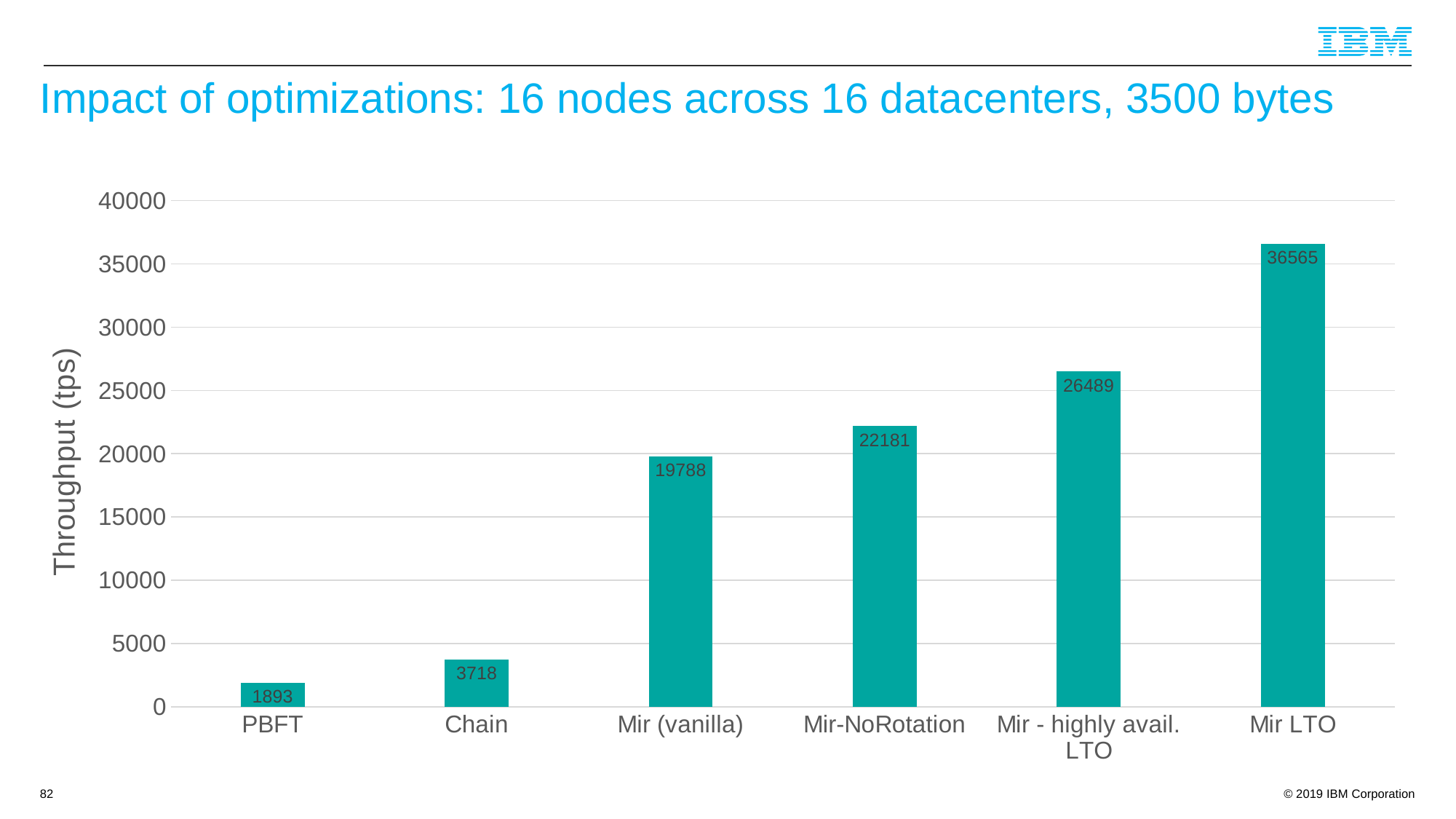
Which category has the lowest throughput? PBFT What type of chart is shown on the slide? Bar chart What is the throughput for PBFT? 1893 Is the throughput for Mir - highly avail. LTO greater or less than 25000? greater How many categories are shown on the x axis? 6 What is the throughput for Mir-NoRotation? 22181 Which category has the highest throughput? Mir LTO What is the difference in throughput between Chain and PBFT? 1825 What is the throughput for Mir LTO? 36565 What is the throughput for Mir (vanilla)? 19788 What is the difference in throughput between Mir LTO and Mir - highly avail. LTO? 10076 Which has a higher throughput, Mir-NoRotation or Mir (vanilla)? Mir-NoRotation